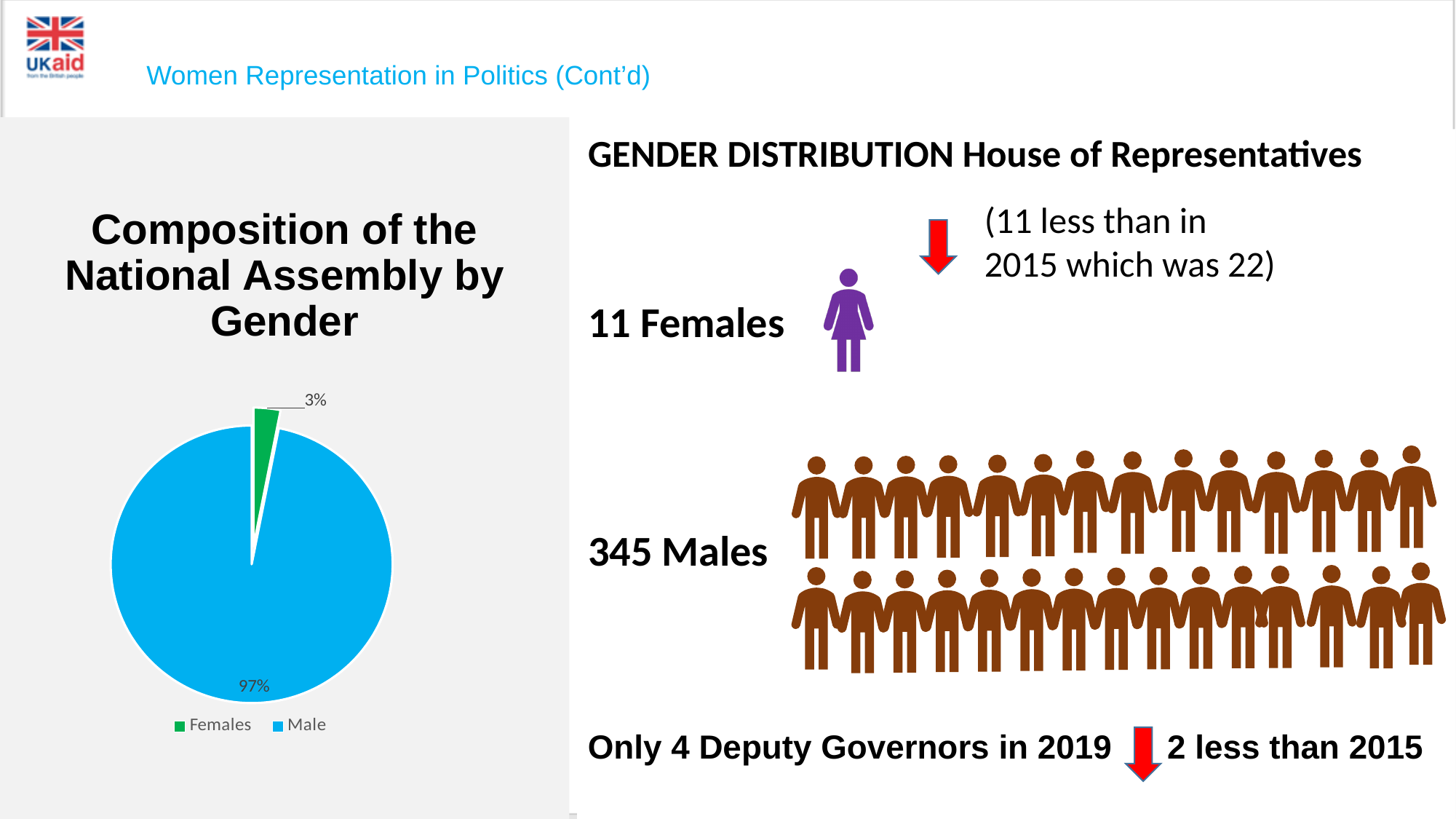
How many categories does the pie chart show? 2 Which slice is larger, Females or Male? Male How many entries does the pie chart legend list? 2 What is the difference in percentage points between the Male and Females slices? 94 What share of the pie chart is Male? 97% Which category has the largest slice in the pie chart? Male Which category has the smallest slice in the pie chart? Females What kind of chart is shown on the slide? pie chart What is the title of the pie chart? Composition of the National Assembly by Gender What colour is the Females slice in the pie chart? green What share of the pie chart is Females? 3%